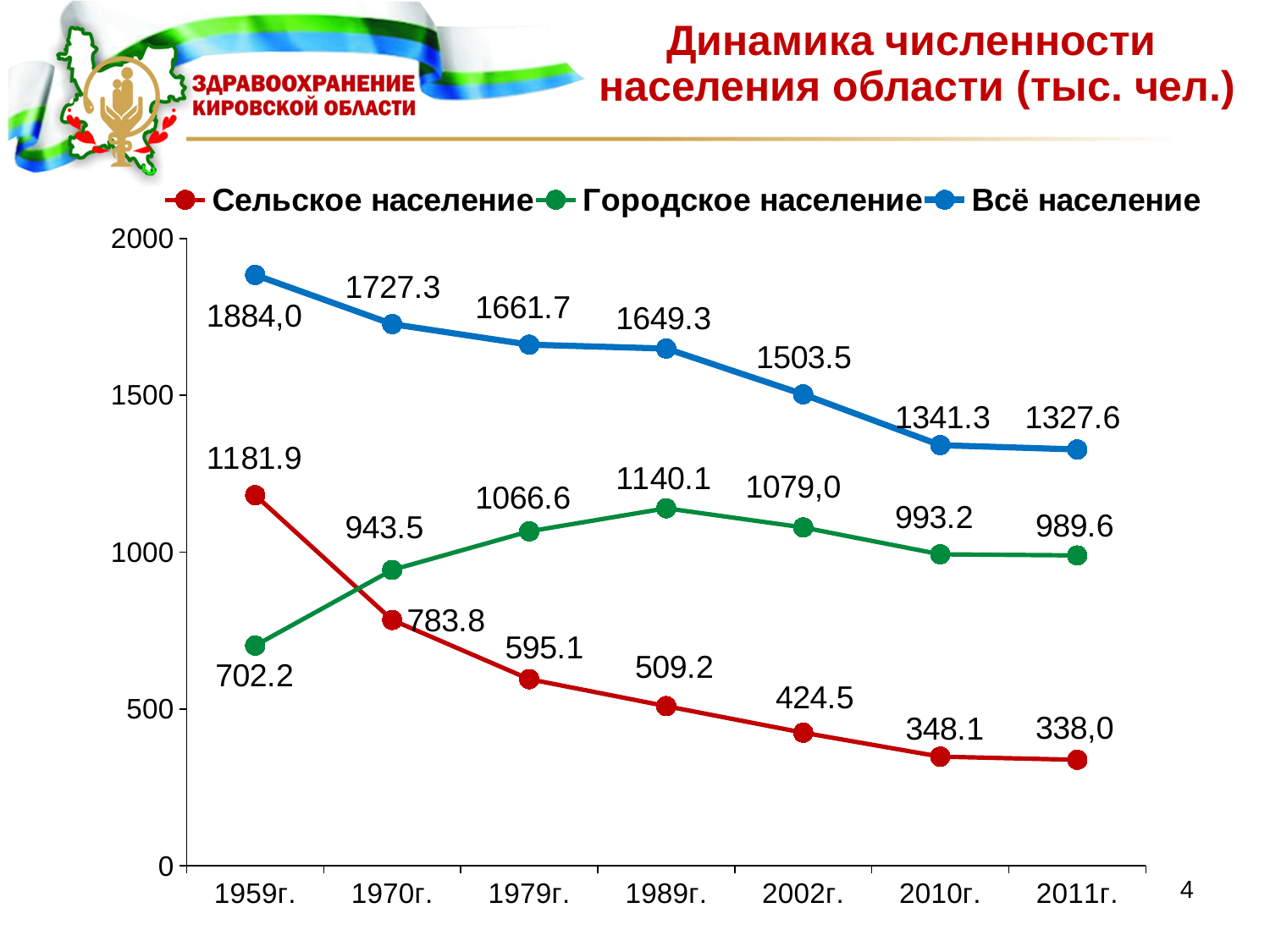
What is the difference between Всё население in 1959г. and in 2011г.? 556.4 Does Сельское население rise or fall from 1959г. to 2011г.? fall In which year is Сельское население lowest? 2011г. In which year is Городское население highest? 1989г. Which is larger in 1970г.: Сельское население or Городское население? Городское население What type of chart is shown on the slide? line chart What is the value for Городское население in 1989г.? 1140.1 How many years are plotted along the x axis? 7 How many series does the legend list? 3 What is the value for Сельское население in 2011г.? 338,0 Which series is shown in blue in the legend? Всё население What is the value for Всё население in 1959г.? 1884,0